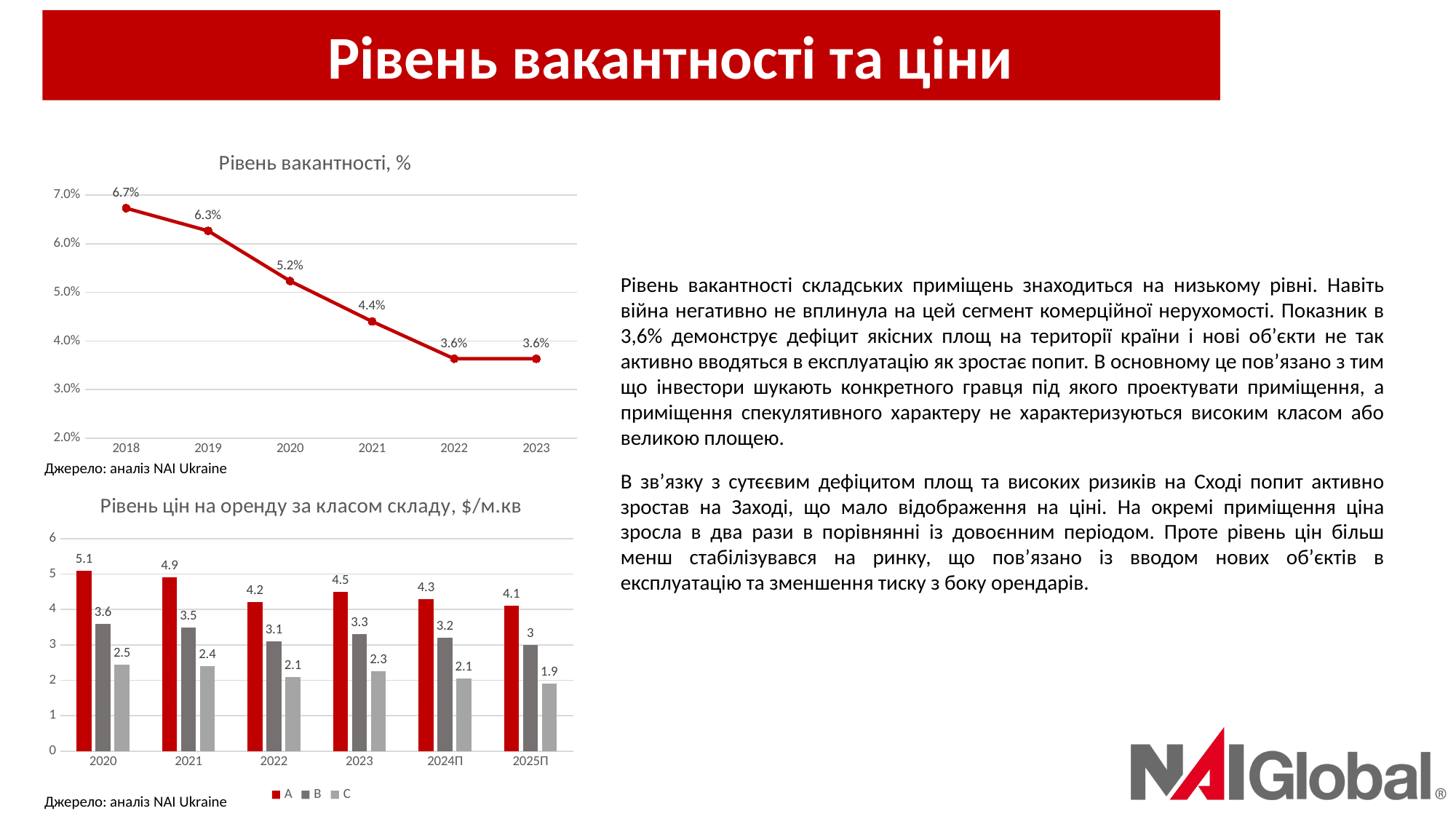
In the chart titled 'Рівень вакантності, %', do the values rise or fall from 2018 to 2022? fall In the chart titled 'Рівень вакантності, %', how many years are plotted? 6 In the chart titled 'Рівень вакантності, %', which year has the lowest vacancy rate shown with a distinct value? 2022 and 2023 (3.6%) In the chart titled 'Рівень вакантності, %', what is the vacancy rate for 2018? 6.7% What kind of chart is 'Рівень вакантності, %'? line chart In the chart titled 'Рівень цін на оренду за класом складу, $/м.кв', which year has the highest class A value? 2020 In the chart titled 'Рівень цін на оренду за класом складу, $/м.кв', how many series does the legend list? 3 In the chart titled 'Рівень цін на оренду за класом складу, $/м.кв', what is the difference between class A and class B in 2021? 1.4 What kind of chart is 'Рівень цін на оренду за класом складу, $/м.кв'? bar chart In the chart titled 'Рівень вакантності, %', what is the difference between the 2018 and 2021 values? 2.3% In the chart titled 'Рівень цін на оренду за класом складу, $/м.кв', what is the value for class A in 2023? 4.5 In the chart titled 'Рівень цін на оренду за класом складу, $/м.кв', what is the value for class C in 2025П? 1.9